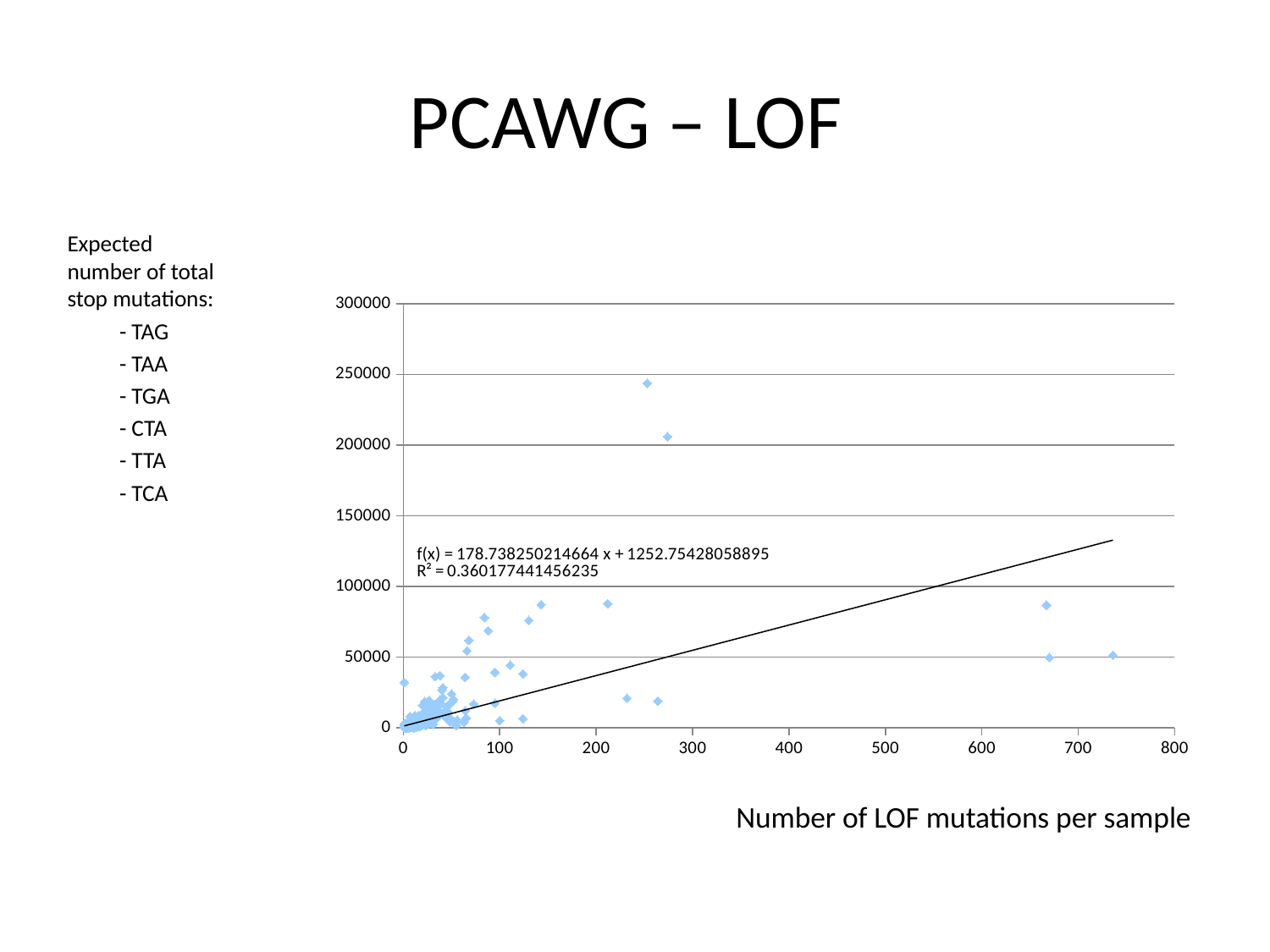
What is the title of the slide containing the chart? PCAWG – LOF Is the highest plotted point on the chart greater or less than 200000 on the y axis? greater What is the slope of the trendline equation printed on the chart? 178.738250214664 Is the highest plotted point on the chart greater or less than 250000 on the y axis? less Does the fitted trendline rise or fall as the number of LOF mutations per sample increases? rise What kind of chart is shown on the slide? scatter plot Is the x value of the rightmost plotted point greater or less than 700? greater What R² value is printed on the chart for the trendline? 0.360177441456235 What is the maximum value shown on the x axis of the chart? 800 What is the maximum value shown on the y axis of the chart? 300000